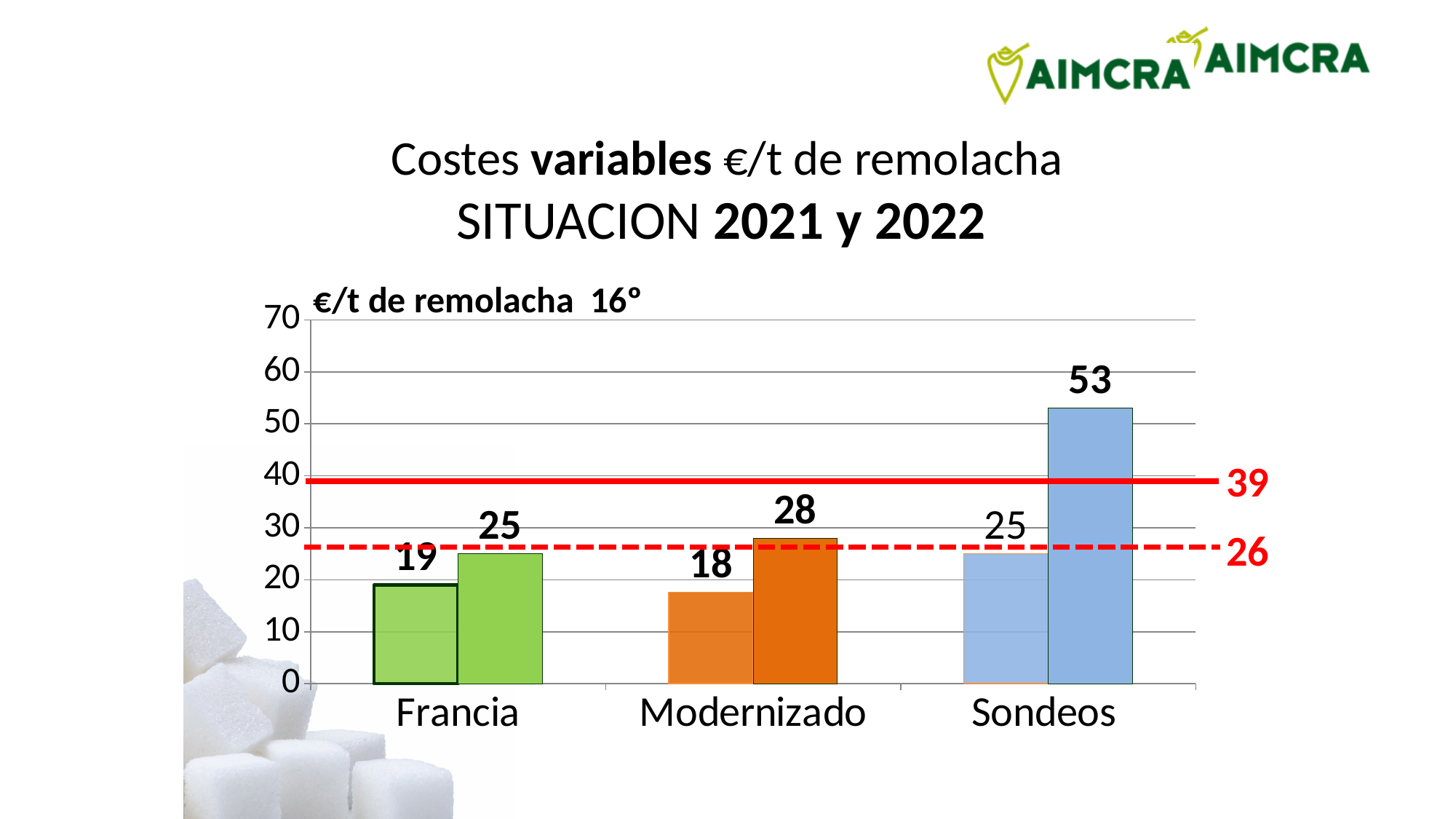
What is the value of the first (lighter) bar for Francia? 19 Which is larger: the second bar for Modernizado or the second bar for Francia? Modernizado Is the value of the second bar for Sondeos greater or less than 50? greater What is the difference between the two bars for Sondeos? 28 Which category has the highest bar in the chart? Sondeos Which category has the lowest bar in the chart? Modernizado What is the value of the second (darker) bar for Sondeos? 53 What is the value of the second (darker) bar for Modernizado? 28 What is the value of the first (lighter) bar for Sondeos? 25 What values are marked by the solid and dashed red horizontal lines on the chart? 39 and 26 How many categories are shown on the x axis of the chart? 3 What type of chart is shown on the slide? bar chart